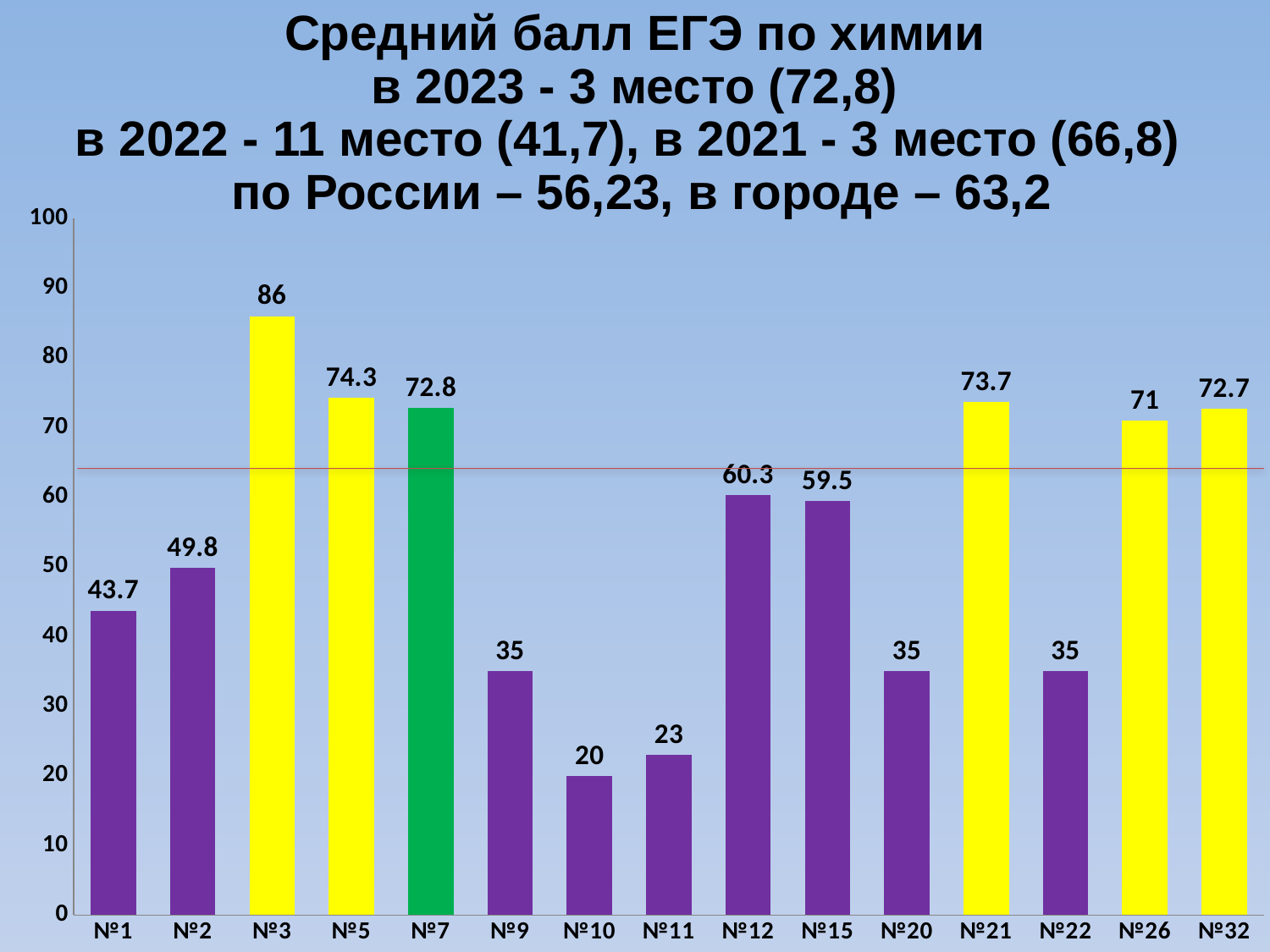
What is the difference between the values for №5 and №7? 1.5 What is the value for №7? 72.8 What is the difference between the values for №3 and №10? 66 Is the value for №1 greater or less than 40? greater Which category has the highest value? №3 Which category has the lowest value? №10 What is the value for №3? 86 How many categories are shown on the x axis? 15 Which is larger, the value for №12 or the value for №15? №12 What kind of chart is this? bar chart What is the value for №12? 60.3 Which category's bar is coloured green? №7